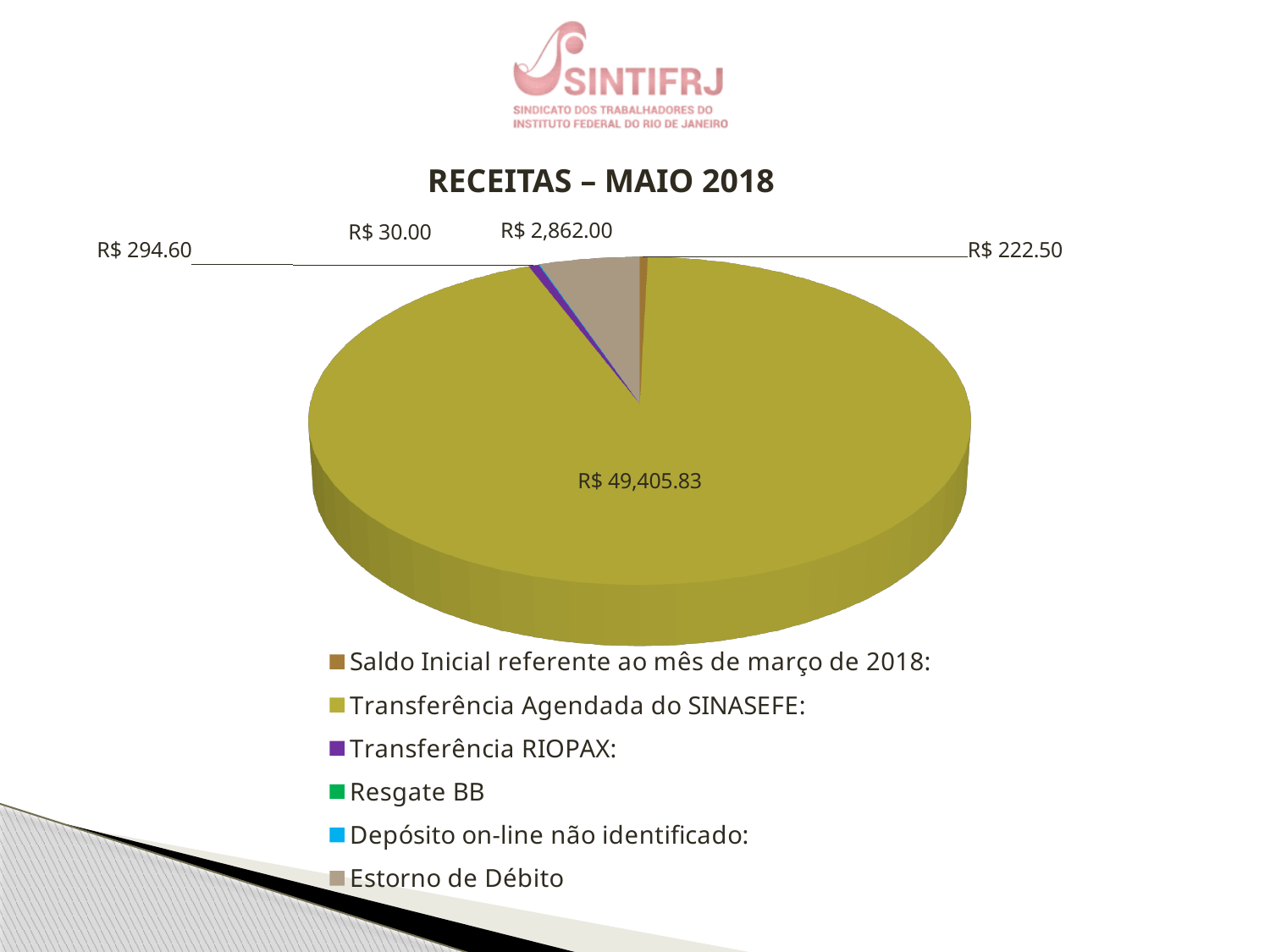
What is the difference between the largest labelled value (R$ 49,405.83) and the second largest labelled value (R$ 2,862.00)? R$ 46,543.83 What is the largest value labelled on the pie chart? R$ 49,405.83 How many data labels are printed on the pie chart? 5 What is the second largest value labelled on the pie chart? R$ 2,862.00 What type of chart is shown on the slide? pie chart What is the smallest value labelled on the pie chart? R$ 30.00 What colour is the largest slice of the pie chart? olive green How many categories does the legend of the pie chart list? 6 What is the value shown for Transferência Agendada do SINASEFE? R$ 49,405.83 Which is larger among the labelled values, R$ 294.60 or R$ 222.50? R$ 294.60 What is the title of the chart? RECEITAS – MAIO 2018 Which category has the largest slice of the pie? Transferência Agendada do SINASEFE